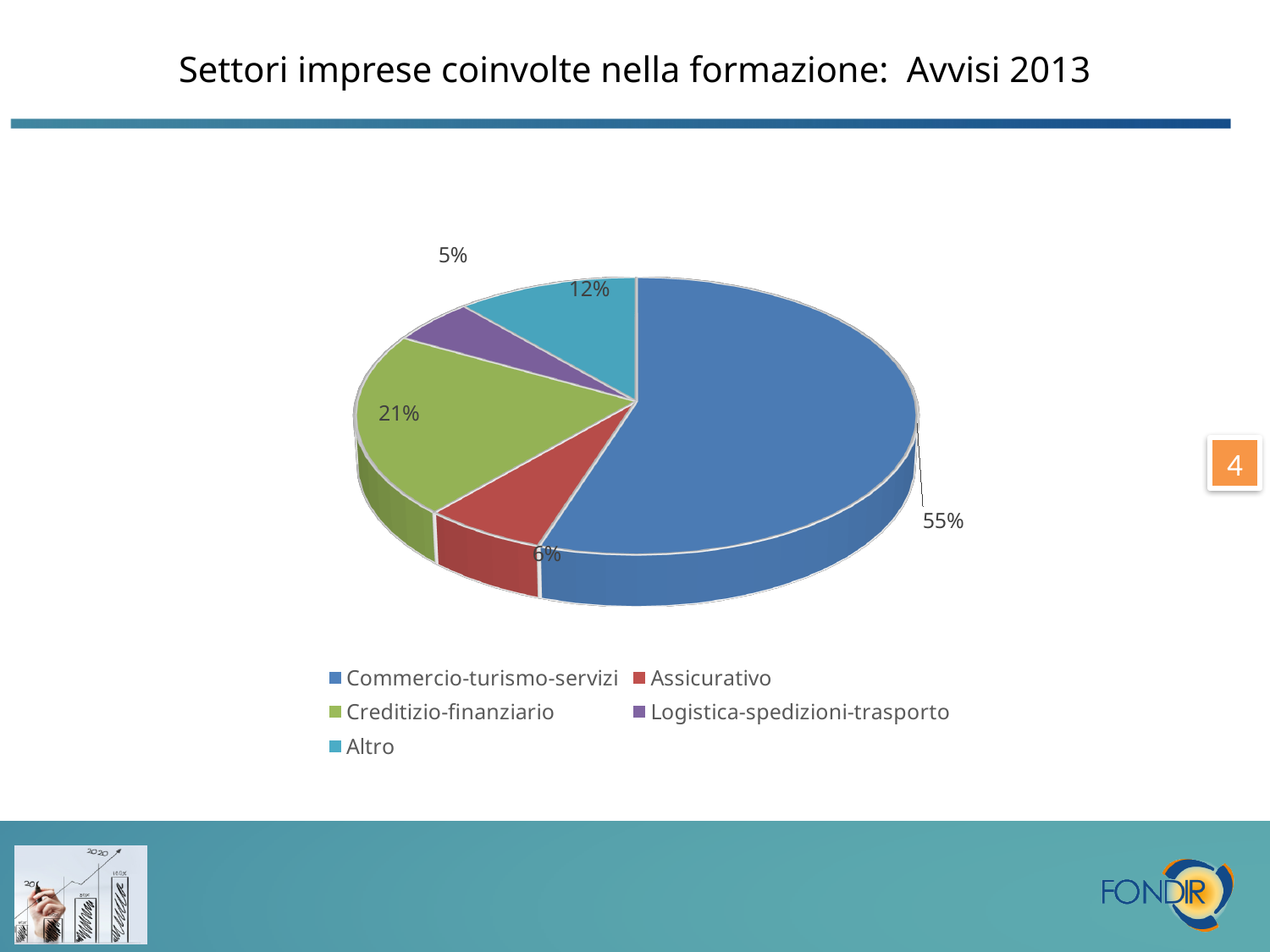
What kind of chart is shown on the slide? pie chart What share of the pie does Commercio-turismo-servizi have? 55% How many sectors are shown in the pie chart? 5 What is the title of the slide containing the pie chart? Settori imprese coinvolte nella formazione: Avvisi 2013 What share of the pie does Altro have? 12% What share of the pie does Logistica-spedizioni-trasporto have? 5% What is the difference in percentage points between Commercio-turismo-servizi and Creditizio-finanziario? 34 percentage points Which sector has the largest slice of the pie? Commercio-turismo-servizi Which is larger, the share for Altro or the share for Assicurativo? Altro Which sector has the smallest slice of the pie? Logistica-spedizioni-trasporto